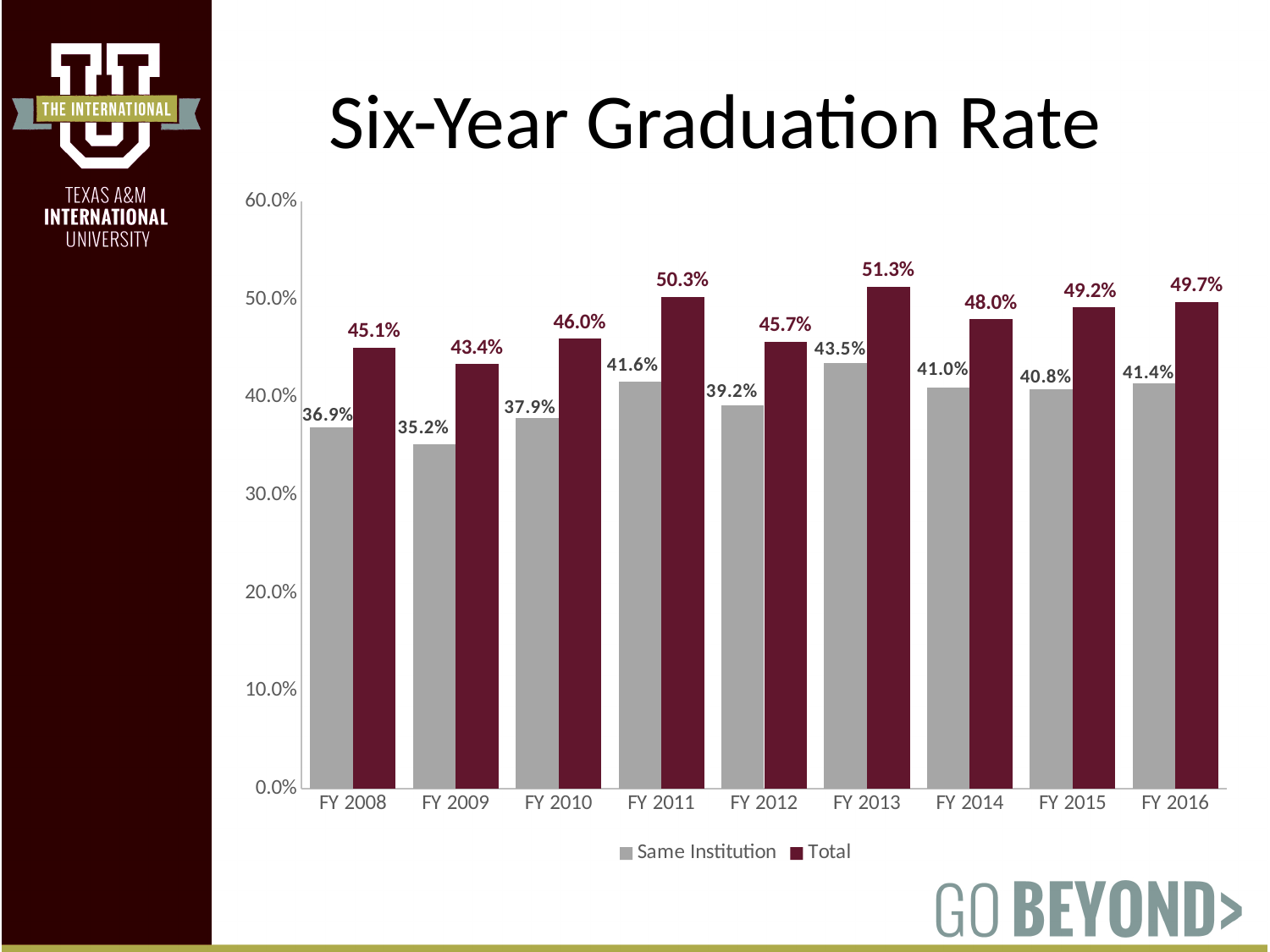
What is the Total six-year graduation rate for FY 2013? 51.3% Which is larger, the Total rate for FY 2014 or the Total rate for FY 2015? FY 2015 Which fiscal year has the lowest Same Institution graduation rate? FY 2009 What is the title of the chart? Six-Year Graduation Rate Does the Total graduation rate rise or fall from FY 2008 to FY 2016 overall? Rise What is the Same Institution six-year graduation rate for FY 2009? 35.2% How many fiscal years are shown on the x axis? 9 What is the difference between the Total and Same Institution rates for FY 2011? 8.7% What kind of chart is shown on the slide? Bar chart Which fiscal year has the highest Total graduation rate? FY 2013 How many series does the legend list? 2 What is the Same Institution value for FY 2016? 41.4%